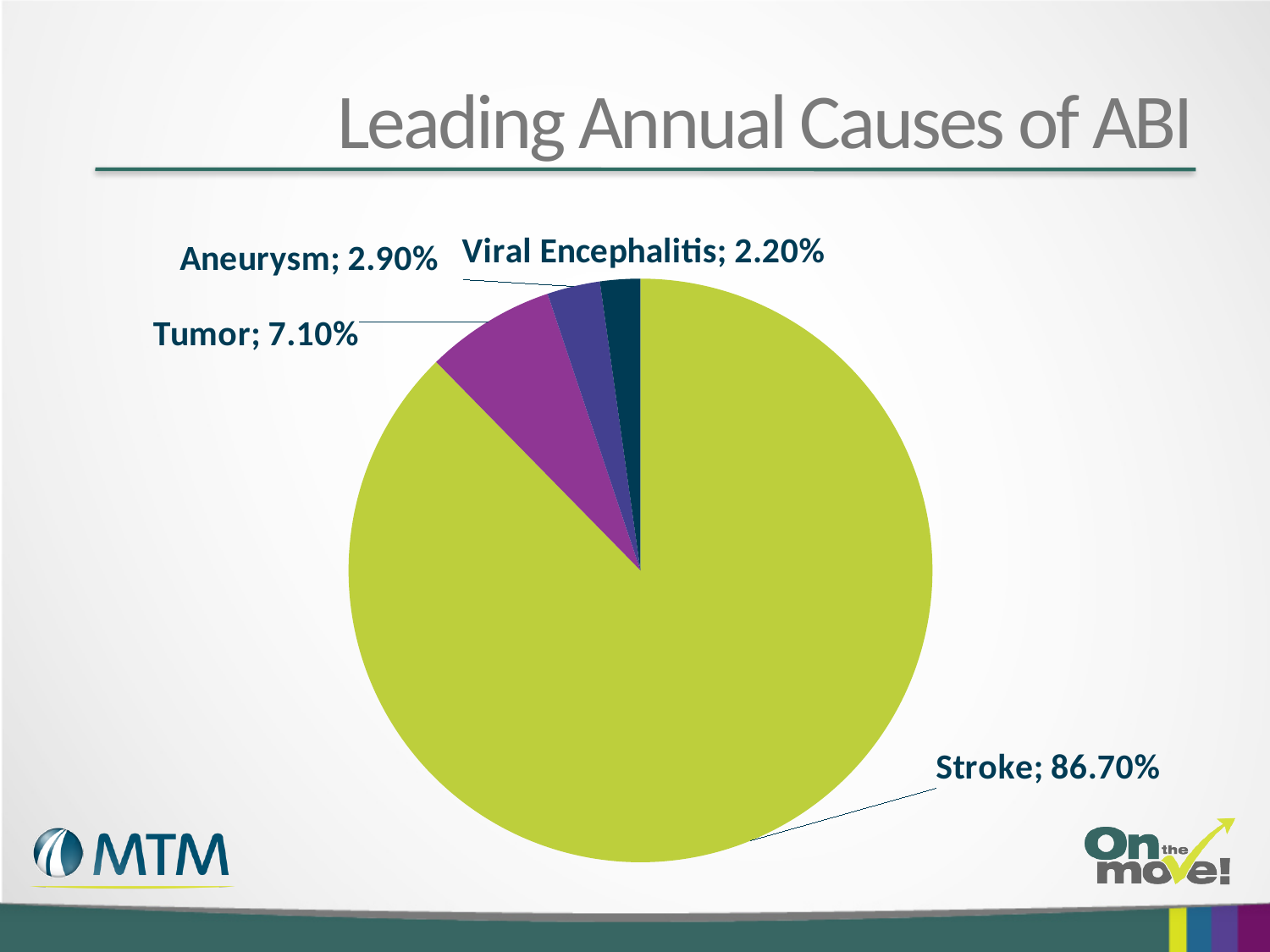
What percentage is shown for Aneurysm? 2.90% Which is larger, the share for Tumor or the share for Aneurysm? Tumor What is the title of the chart? Leading Annual Causes of ABI What kind of chart is shown on the slide? Pie chart What percentage is shown for Tumor? 7.10% What percentage of ABI causes is attributed to Stroke? 86.70% What is the difference in percentage points between Stroke and Tumor? 79.60% What percentage is shown for Viral Encephalitis? 2.20% Which cause has the largest share of the pie? Stroke How many causes are shown in the pie chart? 4 What is the difference in percentage points between Aneurysm and Viral Encephalitis? 0.70% Which cause has the smallest share of the pie? Viral Encephalitis